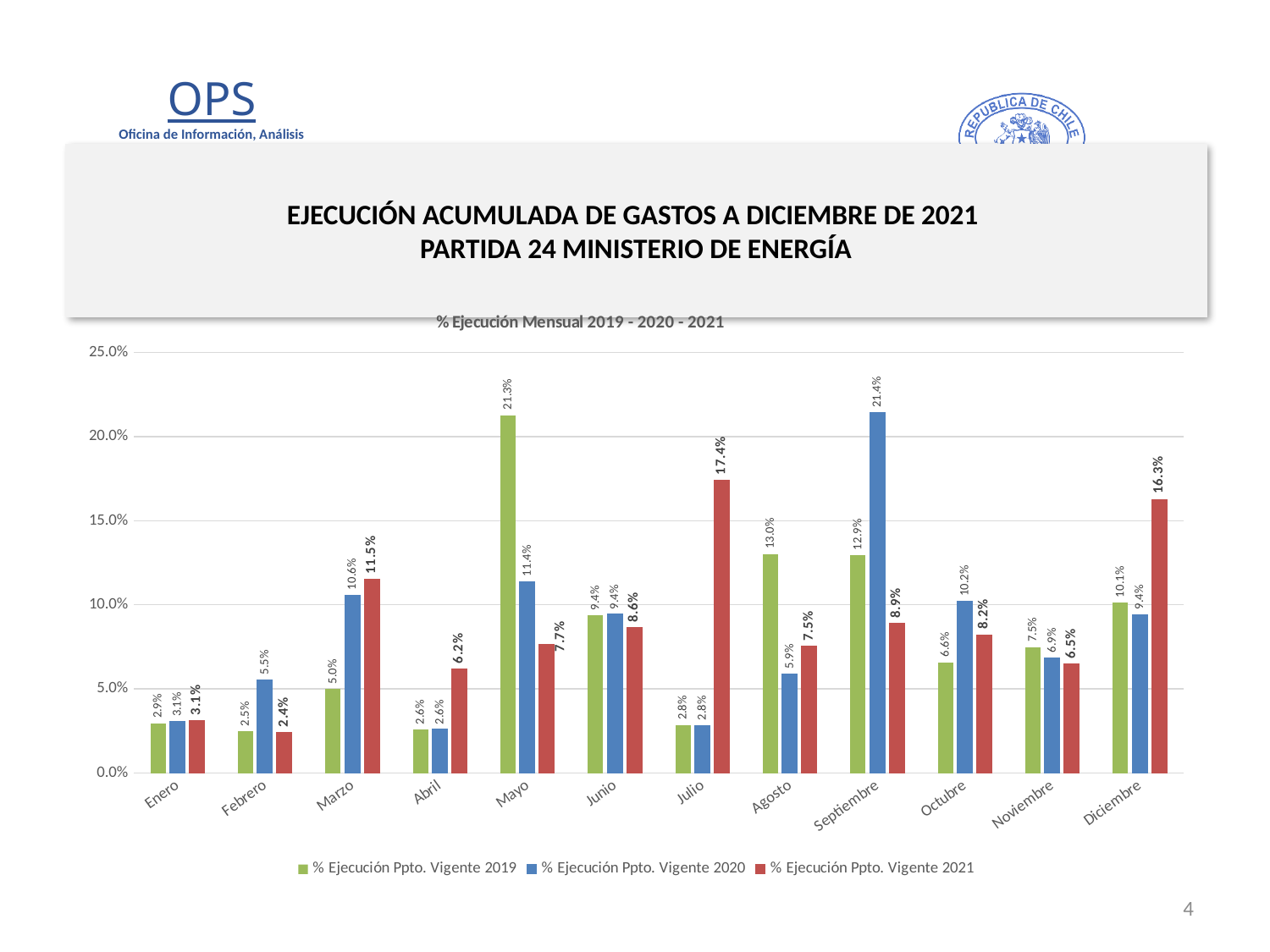
In which month is the % Ejecución Ppto. Vigente 2021 value lowest? Febrero Which colour represents % Ejecución Ppto. Vigente 2021? Red What is the value for % Ejecución Ppto. Vigente 2020 in Octubre? 10.2% What is the value for % Ejecución Ppto. Vigente 2021 in Julio? 17.4% How many series does the legend list? 3 In which month is the % Ejecución Ppto. Vigente 2020 value highest? Septiembre Which is larger in Agosto: the 2019 value or the 2020 value? 2019 value (13.0%) How many months are shown on the x axis? 12 What is the difference between the 2021 and 2019 values in Diciembre? 6.2% What is the value for % Ejecución Ppto. Vigente 2019 in Mayo? 21.3% What is the title of the chart? % Ejecución Mensual 2019 - 2020 - 2021 What type of chart is shown on the slide? Bar chart